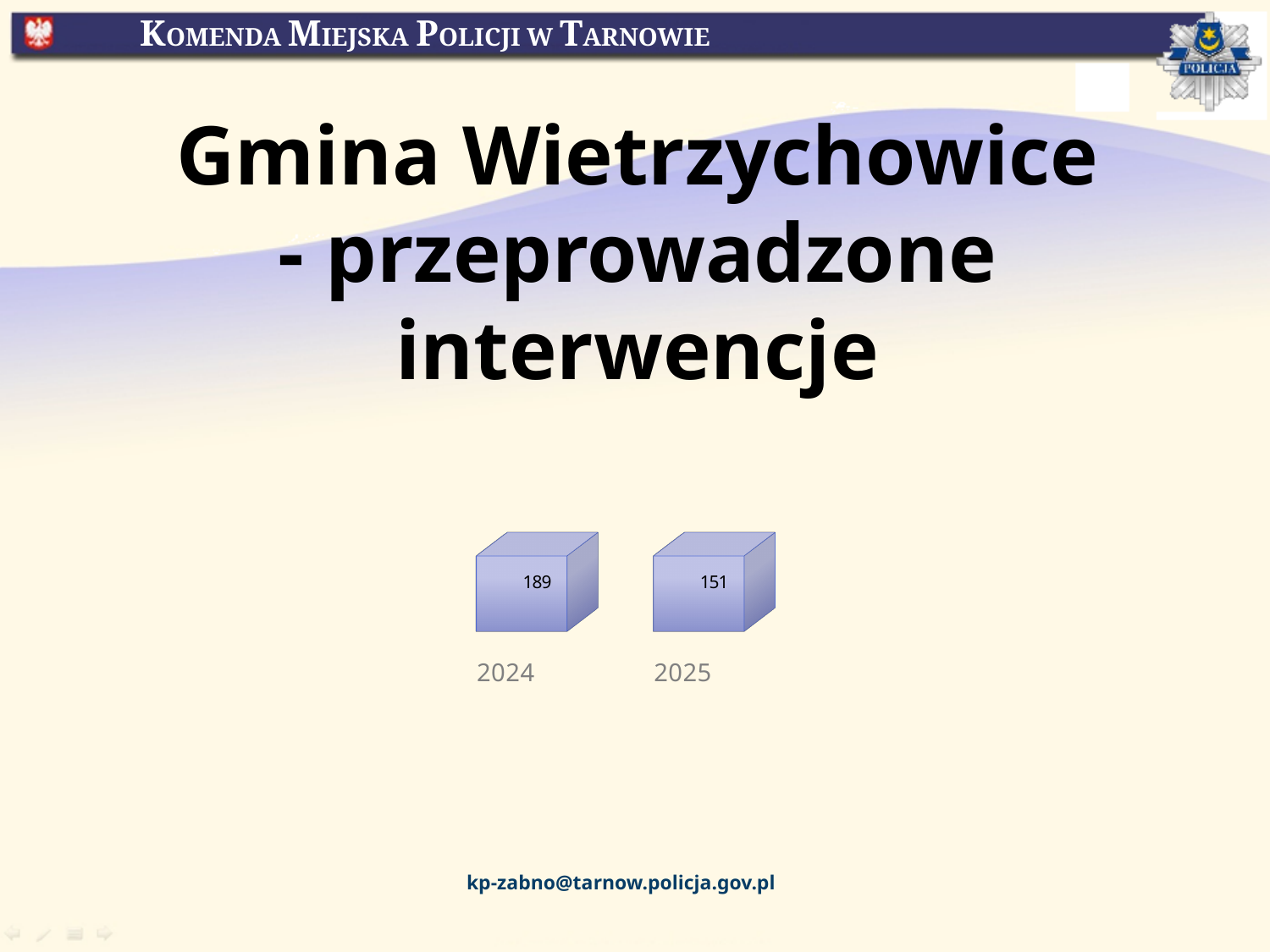
What is the value for 2024? 189 What kind of chart is shown on the slide? bar chart What is the value for 2025? 151 Which year has the higher value? 2024 Is the value for 2024 larger or smaller than the value for 2025? larger What is the title of the slide containing the chart? Gmina Wietrzychowice - przeprowadzone interwencje Which year has the lower value? 2025 How many categories are shown in the chart? 2 Which years are shown on the x axis of the chart? 2024 and 2025 What is the difference between the values for 2024 and 2025? 38 Do the values rise or fall from 2024 to 2025? fall What is the total of the values for 2024 and 2025? 340